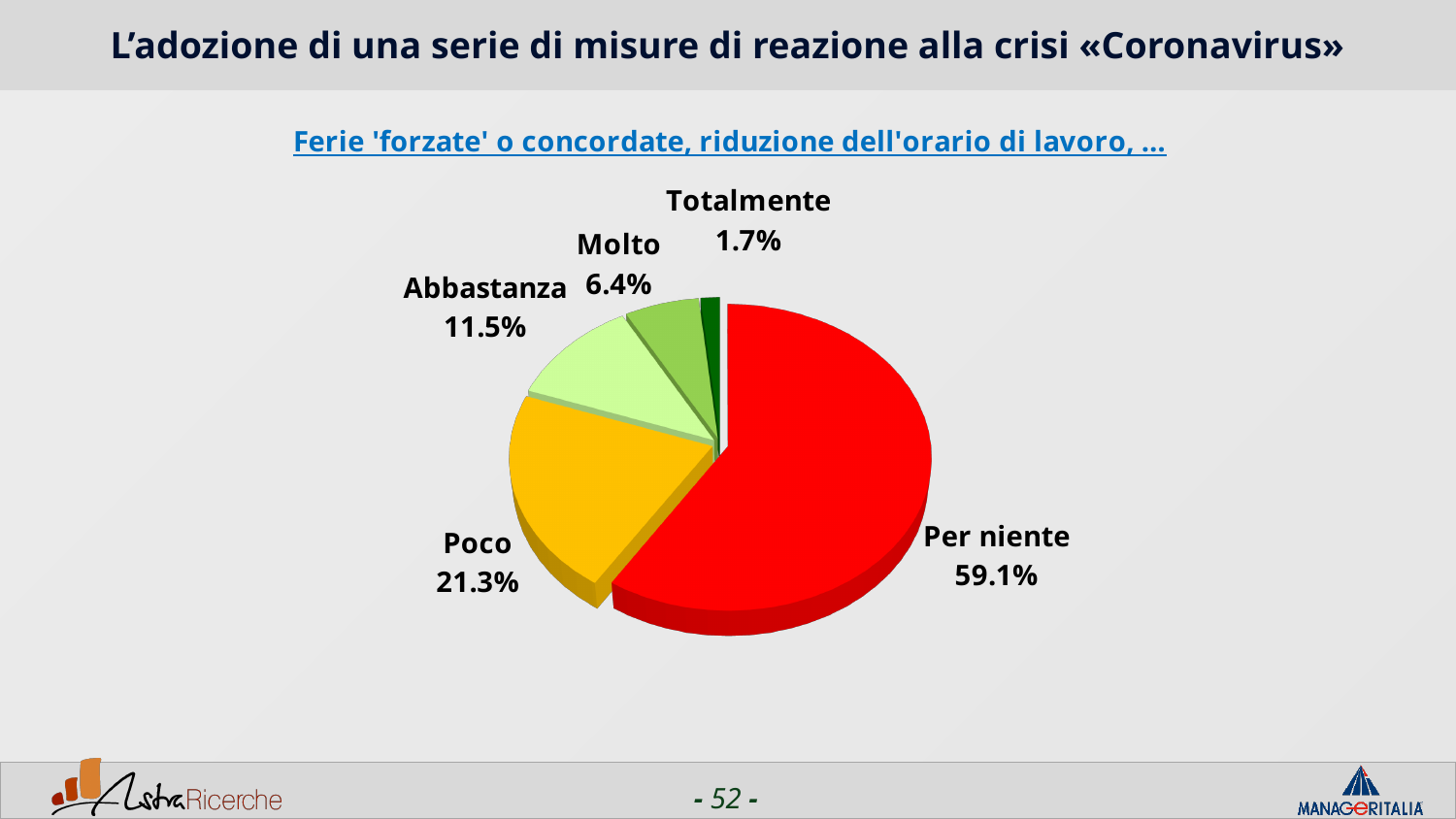
What is the subtitle shown above the pie chart? Ferie 'forzate' o concordate, riduzione dell'orario di lavoro, … Which category has the smallest slice? Totalmente Which is larger, the value for "Abbastanza" or the value for "Molto"? Abbastanza What is the difference between the values for "Per niente" and "Poco"? 37.8% What is the value for "Poco"? 21.3% What kind of chart is shown on the slide? Pie chart What is the value for "Totalmente"? 1.7% How many categories are shown in the pie chart? 5 Which category has the largest slice? Per niente What is the value for "Per niente"? 59.1% What is the value for "Molto"? 6.4% What is the value for "Abbastanza"? 11.5%